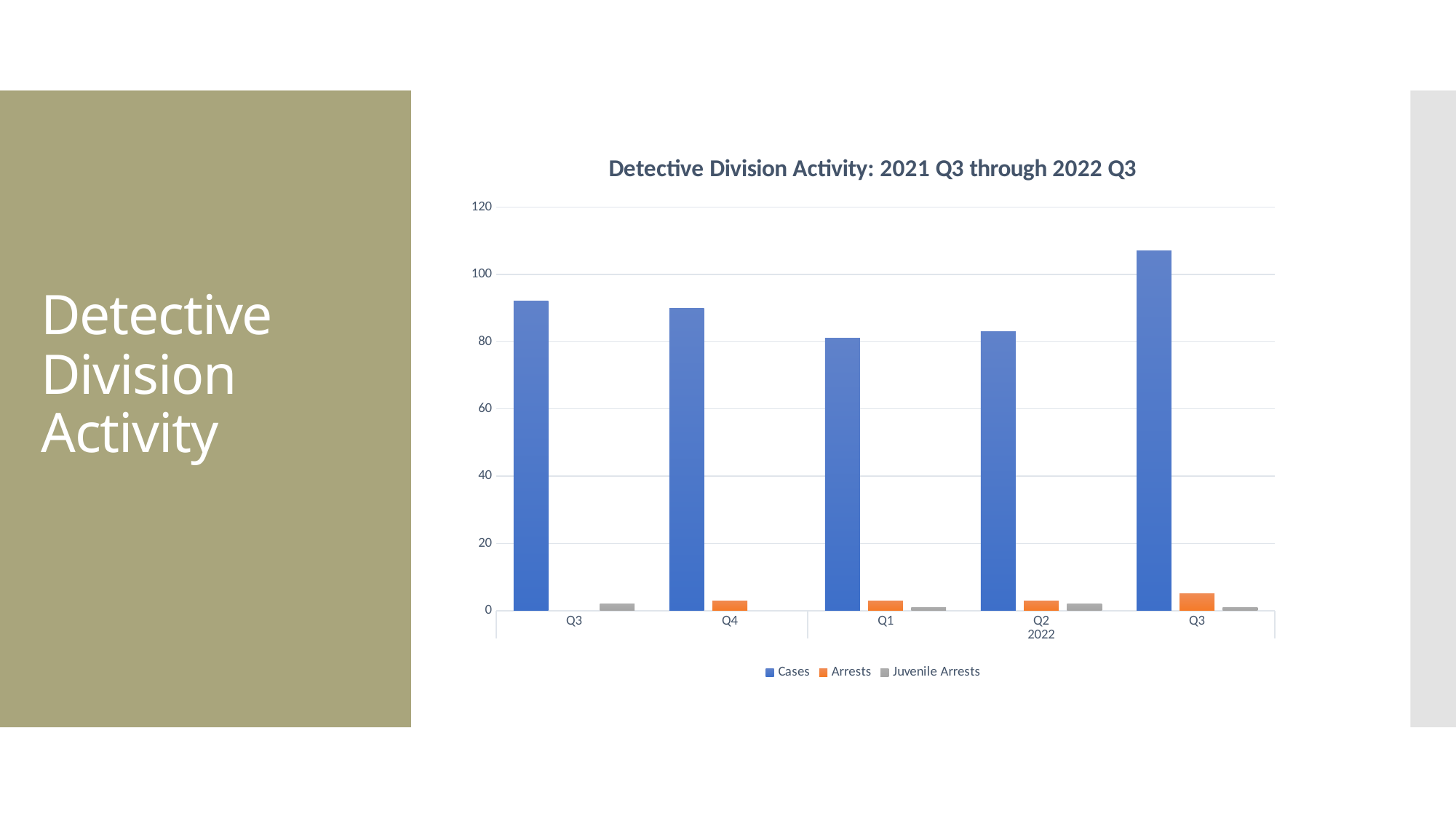
Is the Cases value for 2021 Q3 greater or less than 80? greater Is the Cases value for 2022 Q3 greater or less than 100? greater Which is larger, the Cases value for 2021 Q4 or for 2022 Q1? 2021 Q4 What is the title of the chart? Detective Division Activity: 2021 Q3 through 2022 Q3 What kind of chart is shown on the slide? bar chart Is the Arrests value for 2022 Q3 greater or less than 20? less Which series is shown in orange? Arrests How many series does the legend list? 3 Which is larger, the Cases value for 2021 Q3 or for 2022 Q3? 2022 Q3 In which quarter is the Cases value highest? 2022 Q3 How many quarters are plotted along the x axis? 5